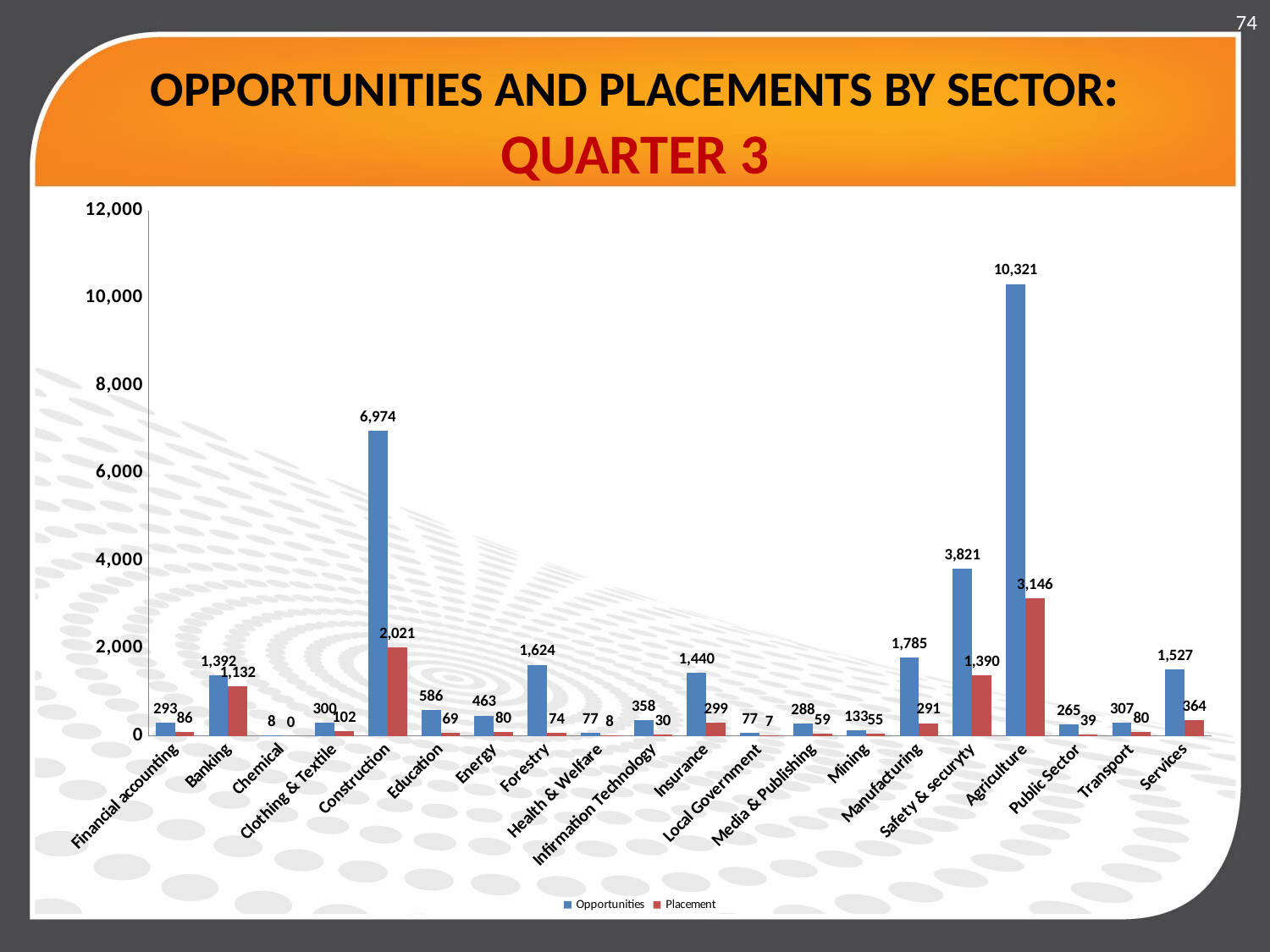
Which has a larger Opportunities value, Forestry or Insurance? Forestry What is the difference between Opportunities and Placement for Construction? 4,953 Which sector has the highest Opportunities value? Agriculture What is the Placement value for Banking? 1,132 How many sectors are shown on the x axis? 20 What kind of chart is shown on the slide? bar chart What is the Placement value for Agriculture? 3,146 How many series does the legend list? 2 What is the difference between Opportunities and Placement for Agriculture? 7,175 Is the Opportunities value for Safety & securyty greater or less than 4,000? less Which sector has the lowest Placement value? Chemical What is the Opportunities value for Construction? 6,974